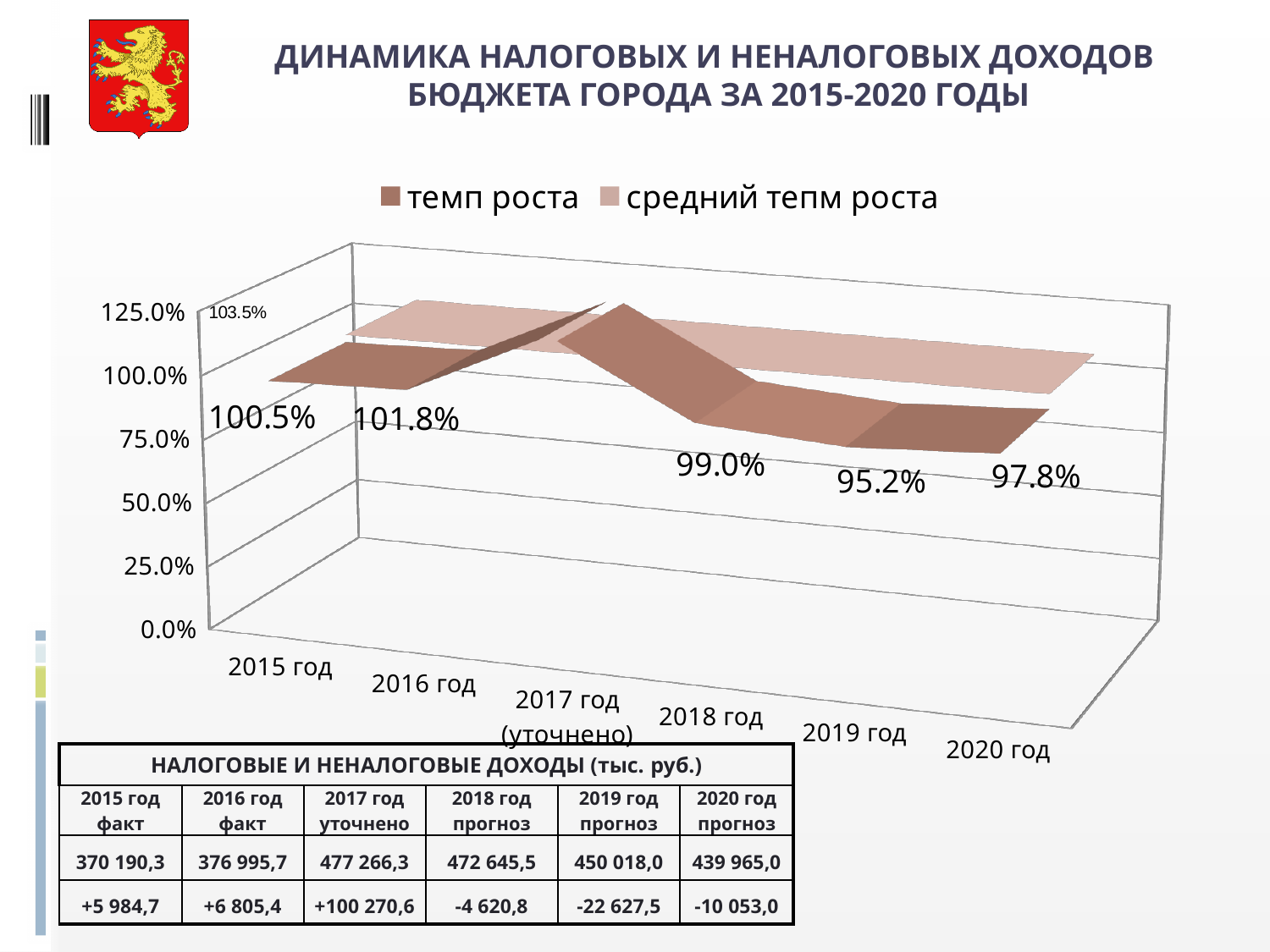
Is the темп роста value for 2017 год (уточнено) greater or less than 100.0%? greater Which year has the highest темп роста value? 2017 год (уточнено) Which year has the lowest темп роста value? 2019 год What is the value of темп роста for 2015 год? 100.5% How many series does the chart legend list? 2 What is the value of темп роста for 2019 год? 95.2% What is the difference between the темп роста values for 2018 год and 2019 год? 3.8% What is the value of темп роста for 2020 год? 97.8% What is the value of темп роста for 2016 год? 101.8% How many years (categories) are plotted along the x axis of the chart? 6 What kind of chart is shown on the slide? 3D line chart What value is labelled for the средний тепм роста series? 103.5%